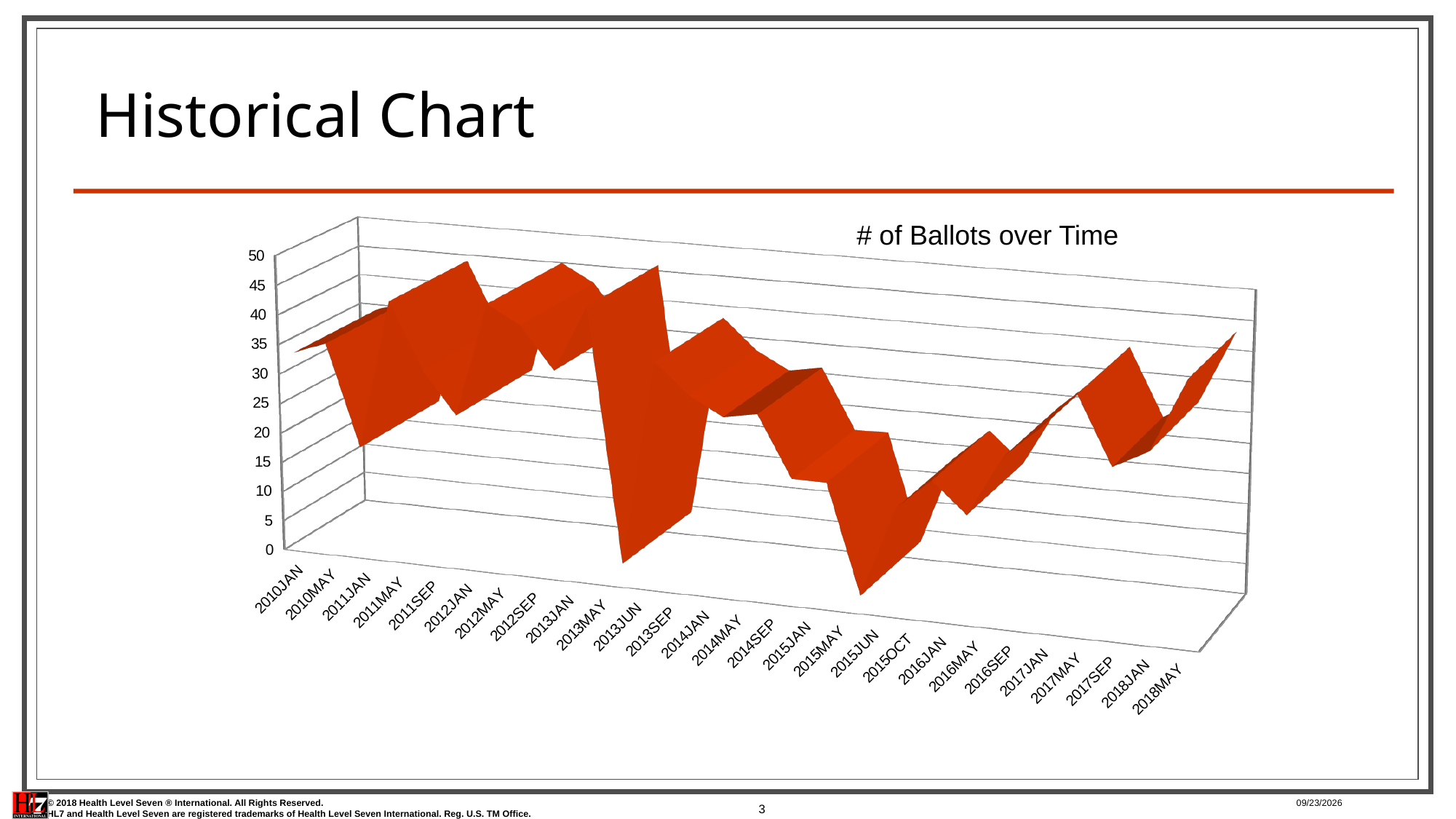
How many time points are shown on the x axis of the chart? 27 What is the title of the chart? # of Ballots over Time Which has the larger value, 2015JUN or 2018MAY? 2018MAY Is the value for 2011MAY greater or less than 30? greater Which has the larger value, 2013MAY or 2013JUN? 2013MAY What is the first category on the x axis? 2010JAN What kind of chart is shown on the slide? Line chart Do the values generally rise or fall from 2015JUN to 2018MAY? rise Is the value for 2013JUN greater or less than 10? less Is the value for 2018MAY greater or less than 20? greater Do the values rise or fall from 2013MAY to 2013JUN? fall